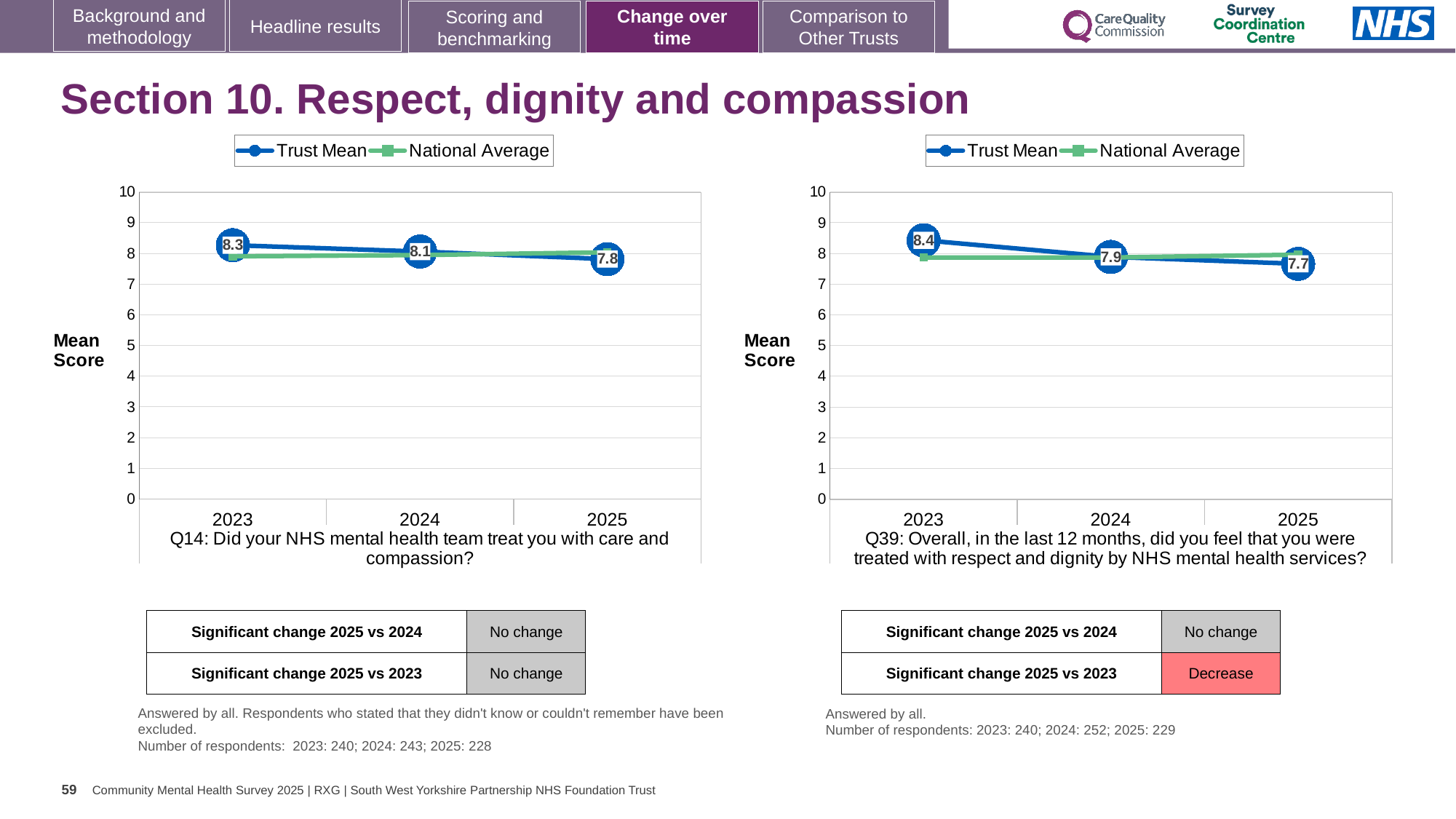
What kind of chart is the left chart (Q14)? Line chart How many years are shown on the x axis of the left chart (Q14)? 3 In the right chart (Q39), which year has the highest Trust Mean? 2023 In the left chart (Q14), what is the Trust Mean for 2023? 8.3 In the left chart (Q14), is the Trust Mean higher in 2023 or in 2024? 2023 How many series does the legend of the right chart (Q39) list? 2 In the right chart (Q39), what is the Trust Mean for 2024? 7.9 In the left chart (Q14), which year has the lowest Trust Mean? 2025 In the left chart (Q14), what is the Trust Mean for 2025? 7.8 In the right chart (Q39), what is the difference between the Trust Mean for 2023 and 2025? 0.7 In the right chart (Q39), does the Trust Mean rise or fall from 2023 to 2025? Fall In the right chart (Q39), is the National Average for 2023 greater or less than 5? greater